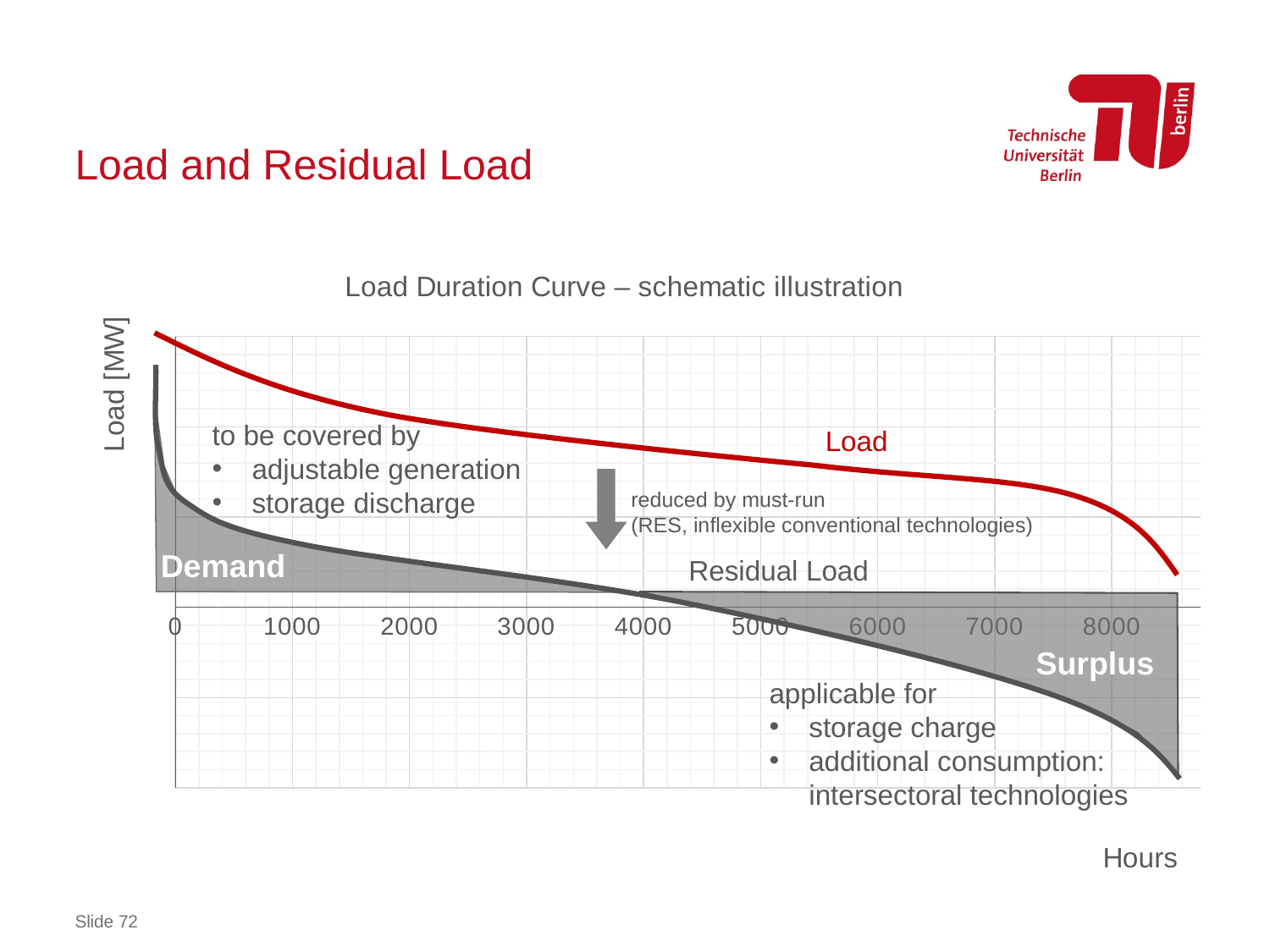
What is the title of the chart? Load Duration Curve – schematic illustration What is the largest tick value shown on the Hours axis? 8000 What kind of chart is shown on the slide? line chart How many curves (series) are plotted on the chart? 2 Is the Load value at 8000 hours greater or less than 0? greater Does the Load curve rise or fall as hours increase along the x axis? fall Does the Residual Load curve rise or fall as hours increase along the x axis? fall Which curve is higher at 7000 hours, Load or Residual Load? Load Is the Residual Load value at 2000 hours greater or less than 0? greater Is the Residual Load value at 6000 hours greater or less than 0? less What is the label of the vertical axis? Load [MW] Which curve is higher at 2000 hours, Load or Residual Load? Load